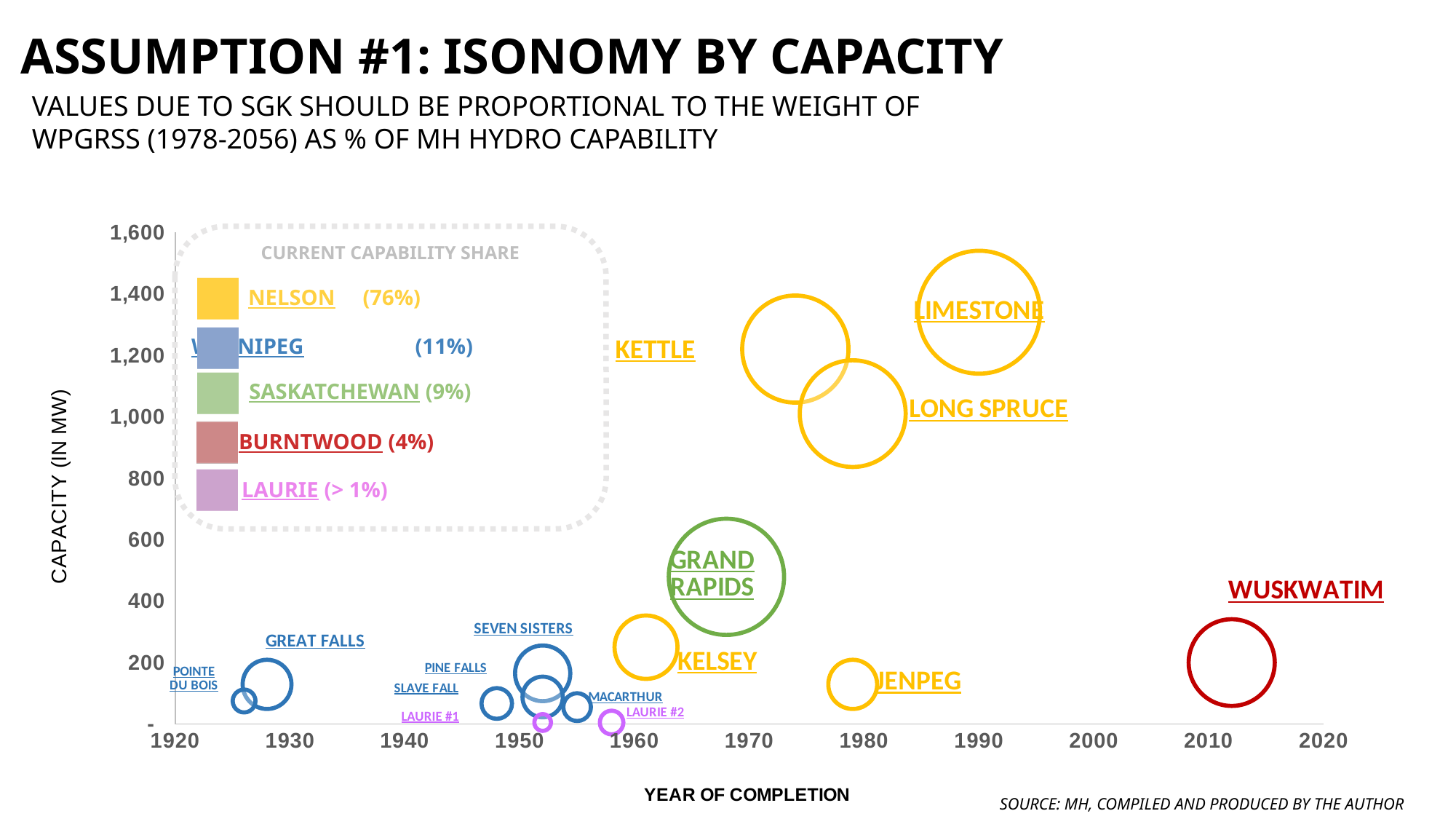
What is the current capability share shown for Burntwood? 4% How many river systems are listed in the 'Current Capability Share' legend? 5 Which station has the highest capacity on the chart? Limestone What is the difference in percentage points between the Nelson share and the Winnipeg share? 65 percentage points What is the current capability share shown for Winnipeg? 11% Is the capacity of Grand Rapids greater or less than 600 MW? less Which has the larger capacity, Grand Rapids or Kelsey? Grand Rapids What is the current capability share shown for Saskatchewan? 9% Is the capacity of Limestone greater or less than 1,200 MW? greater What is the current capability share shown for Nelson in the legend? 76% What kind of chart is shown on the slide? Bubble chart Which station was completed most recently according to the x axis? Wuskwatim